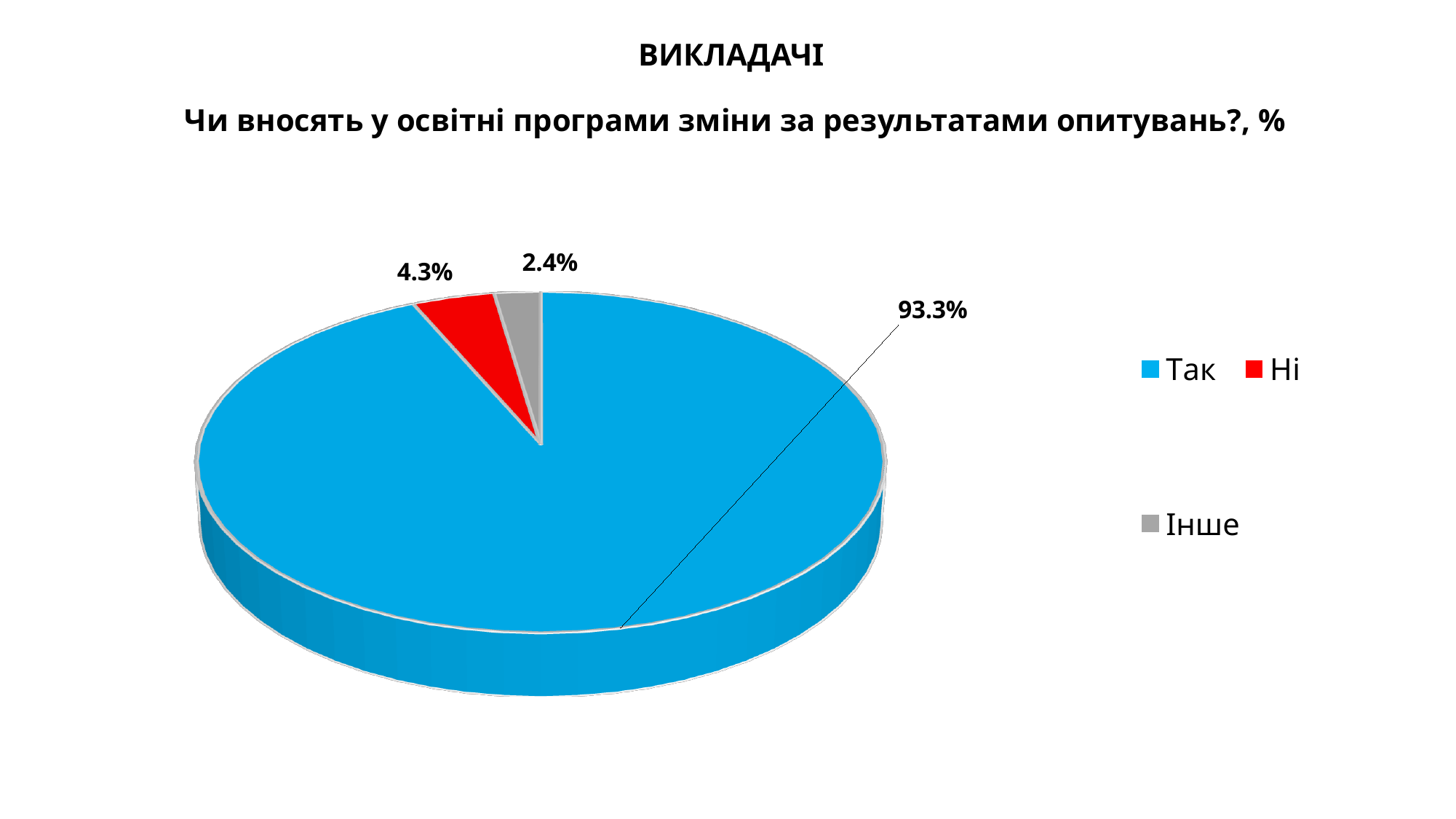
Which category has the smallest slice? Інше What is the value for "Ні"? 4.3% What is the value for "Так"? 93.3% What is the value for "Інше"? 2.4% What is the difference between the values for "Так" and "Ні"? 89.0% How many slices does the pie chart have? 3 What kind of chart is shown on the slide? Pie chart Which is larger, the value for "Ні" or the value for "Інше"? Ні What colour is the slice for "Ні"? Red What is the difference between the values for "Ні" and "Інше"? 1.9% Which category has the largest slice? Так How many entries does the legend list? 3